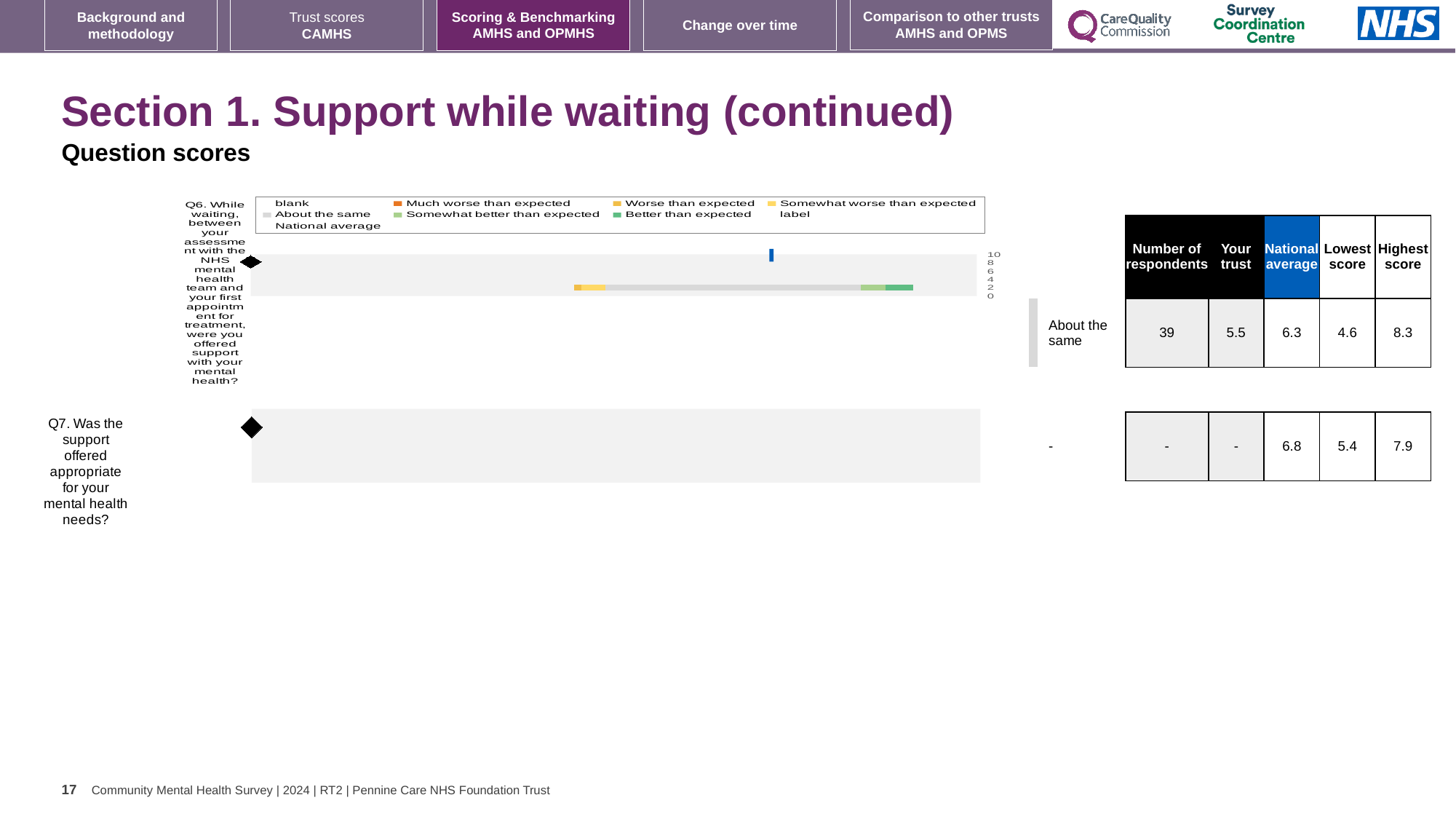
Is the trust's score for Q6 greater or less than 6? less According to the table next to the Q6 chart, what is the 'Your trust' score for Q6? 5.5 According to the table next to the Q6 chart, what is the national average for Q6? 6.3 What category label is given for the trust's Q6 result? About the same What is the maximum value shown on the axis of the Q6 chart? 10 What is the difference between the highest score (8.3) and the lowest score (4.6) for Q6? 3.7 For Q6, which is larger: the trust's score or the national average? national average What is the highest score for Q7? 7.9 What is the national average for Q7? 6.8 What kind of chart is used for Q6 on the slide? bar chart In the Q6 chart legend, what colour represents 'Better than expected'? green How many respondents answered Q6? 39